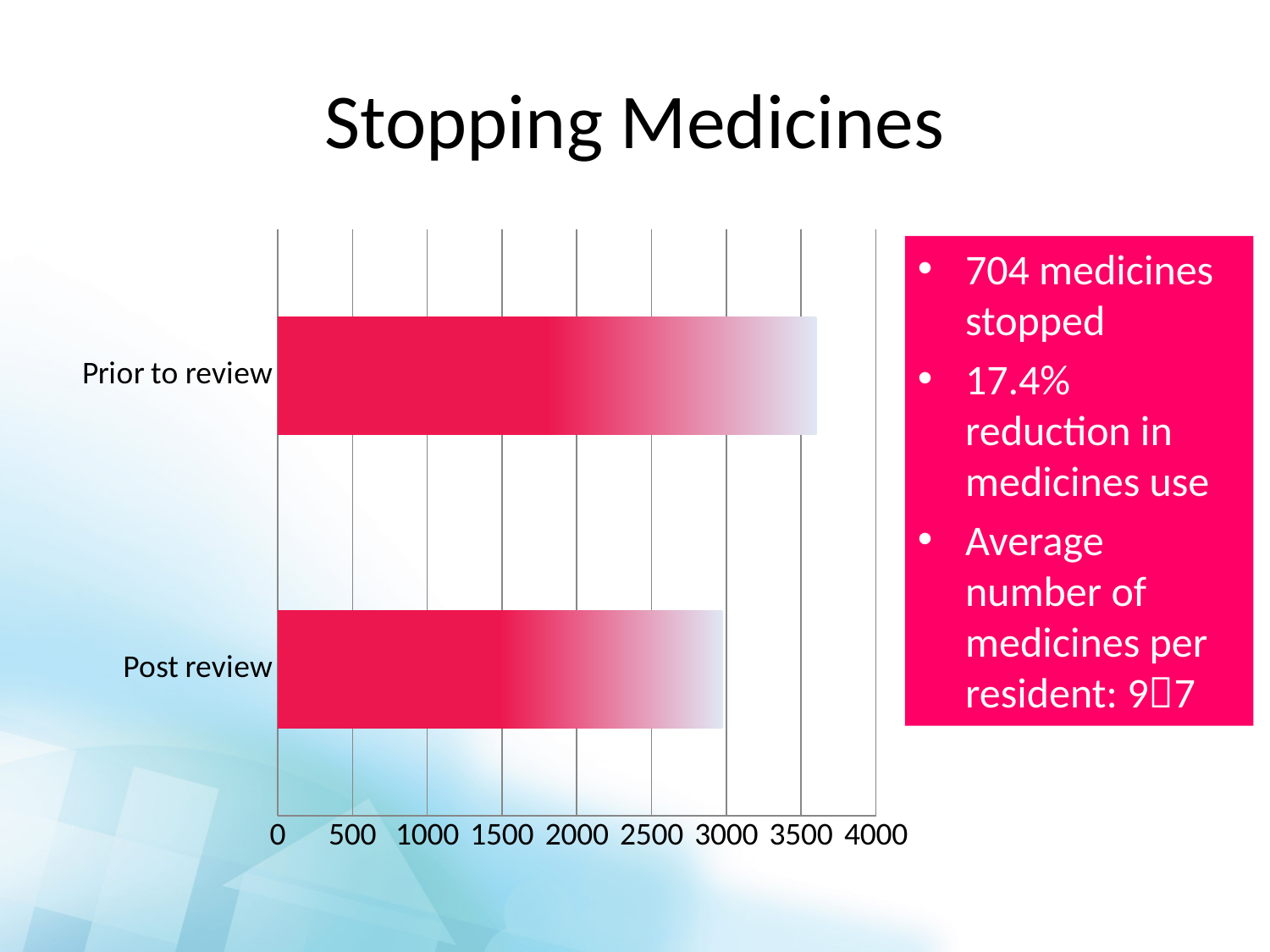
Which category has the highest value in the chart? Prior to review Which is larger, the value for Prior to review or the value for Post review? Prior to review What is the title of the slide containing the chart? Stopping Medicines Which category has the lowest value in the chart? Post review What is the highest value shown on the chart's horizontal axis? 4000 Is the value for Prior to review greater or less than 3000? greater What kind of chart is shown on the slide? bar chart Is the value for Prior to review greater or less than 4000? less How many categories are plotted in the chart? 2 Is the value for Post review greater or less than 3500? less